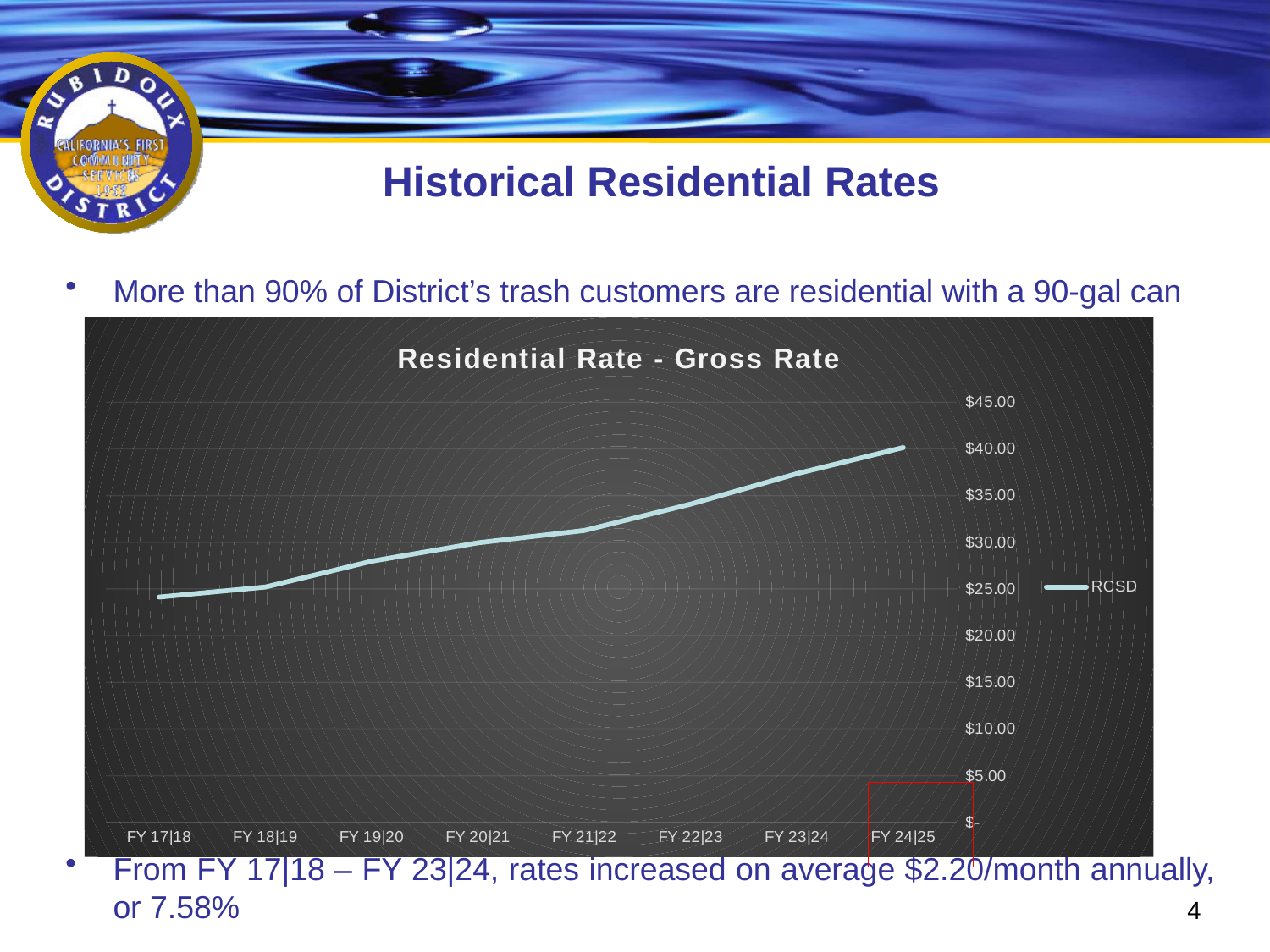
Do the residential gross rates rise or fall from FY 17|18 to FY 24|25? rise How many fiscal years are plotted along the x axis of the chart? 8 Is the value for FY 24|25 greater or less than $35.00? greater Is the value for FY 17|18 greater or less than $30.00? less Is the value for FY 19|20 greater or less than $25.00? greater How many series does the chart's legend list? 1 What is the name of the series shown in the chart's legend? RCSD Which is larger, the rate for FY 24|25 or the rate for FY 17|18? FY 24|25 Which fiscal year has the lowest residential gross rate in the chart? FY 17|18 Which fiscal year has the highest residential gross rate in the chart? FY 24|25 What is the title of the chart? Residential Rate - Gross Rate What kind of chart is shown on the slide? line chart